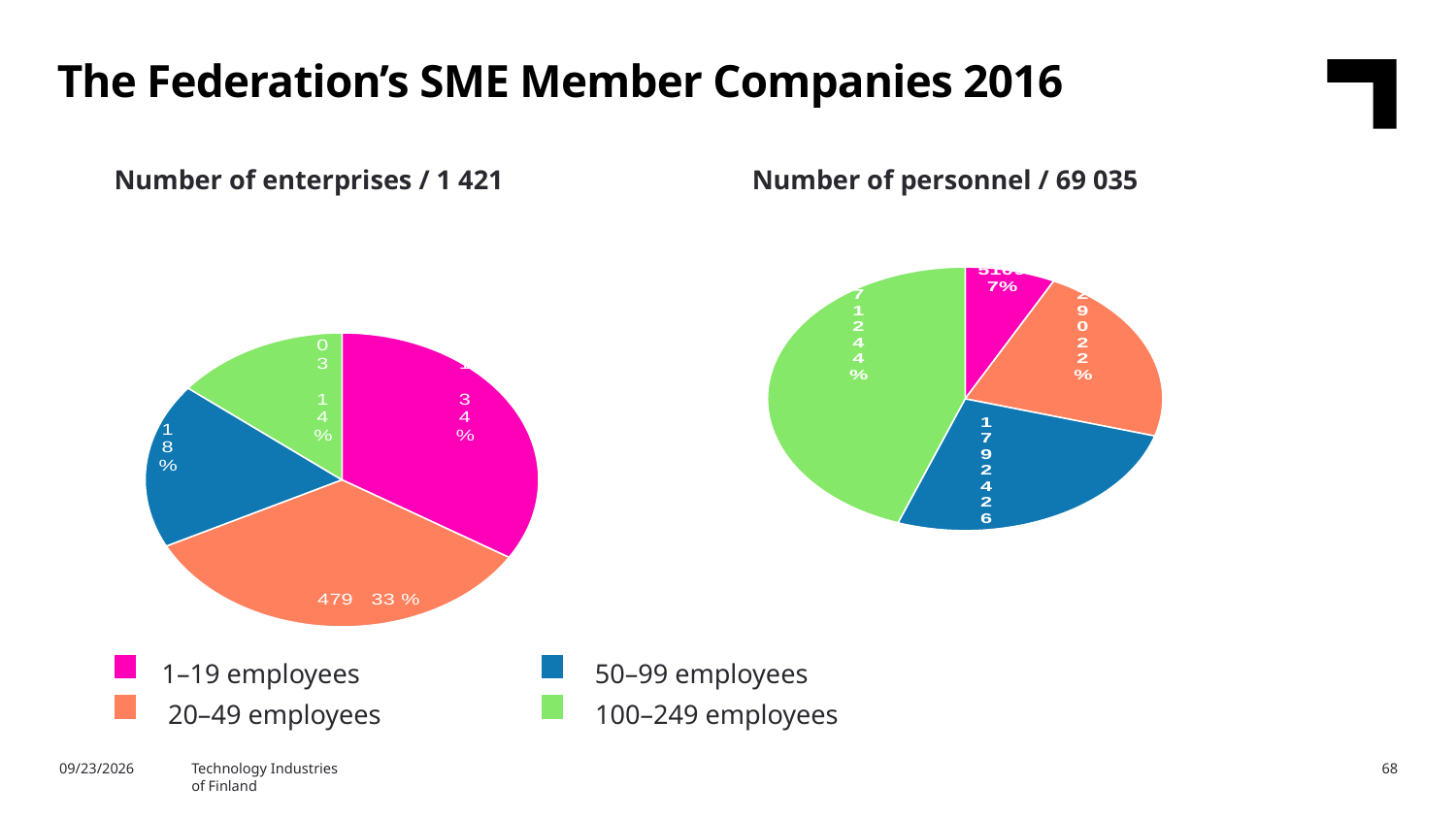
What kind of charts are shown on the slide? Pie charts In the 'Number of enterprises / 1 421' chart, what share do companies with 20–49 employees have? 33 % In the 'Number of enterprises / 1 421' chart, what share do companies with 100–249 employees have? 14 % In the 'Number of enterprises / 1 421' chart, what share do companies with 50–99 employees have? 18 % How many employee-size categories does the legend list? 4 In the 'Number of enterprises / 1 421' chart, which category has the smallest slice? 100–249 employees In the 'Number of personnel / 69 035' chart, what share do companies with 100–249 employees have? 44% In the 'Number of enterprises / 1 421' chart, what share do companies with 1–19 employees have? 34 % Which colour represents companies with 50–99 employees in the legend? Blue In the 'Number of personnel / 69 035' chart, which category has the largest slice? 100–249 employees In the 'Number of enterprises / 1 421' chart, how many enterprises have 20–49 employees? 479 In the 'Number of personnel / 69 035' chart, what share do companies with 1–19 employees have? 7%